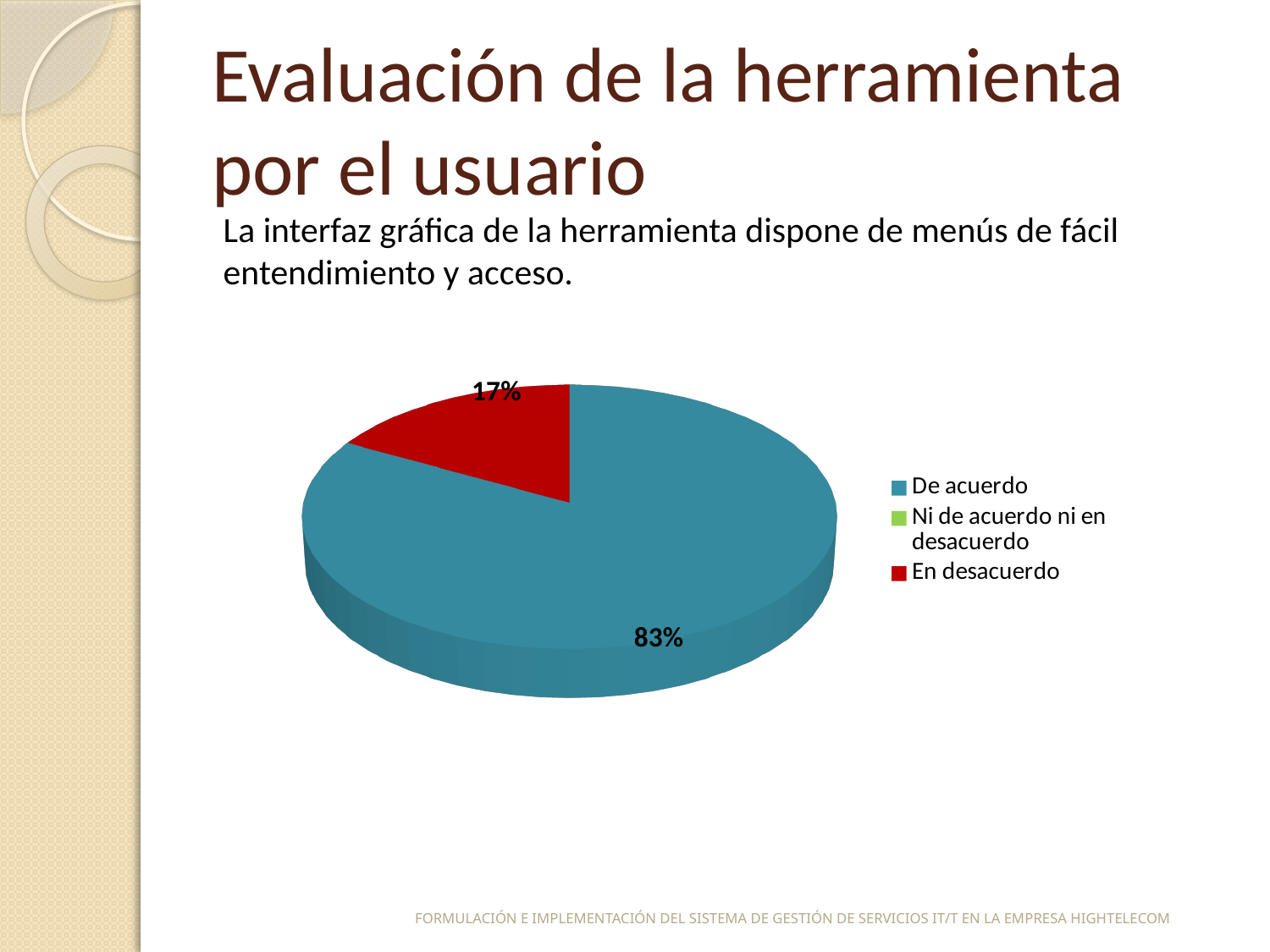
Which of the visible slices is the smallest? En desacuerdo Is the share for "De acuerdo" greater or less than 50%? greater How many entries does the legend list? 3 What share of the pie does "De acuerdo" represent? 83% Which category has the largest slice of the pie? De acuerdo What share of the pie does "En desacuerdo" represent? 17% How many slices are visible in the pie? 2 What colour is the "En desacuerdo" slice? red Which is larger, the "De acuerdo" slice or the "En desacuerdo" slice? De acuerdo What kind of chart is shown on the slide? pie chart What is the difference in percentage points between the "De acuerdo" and "En desacuerdo" slices? 66 Which legend entry has no visible slice in the pie? Ni de acuerdo ni en desacuerdo